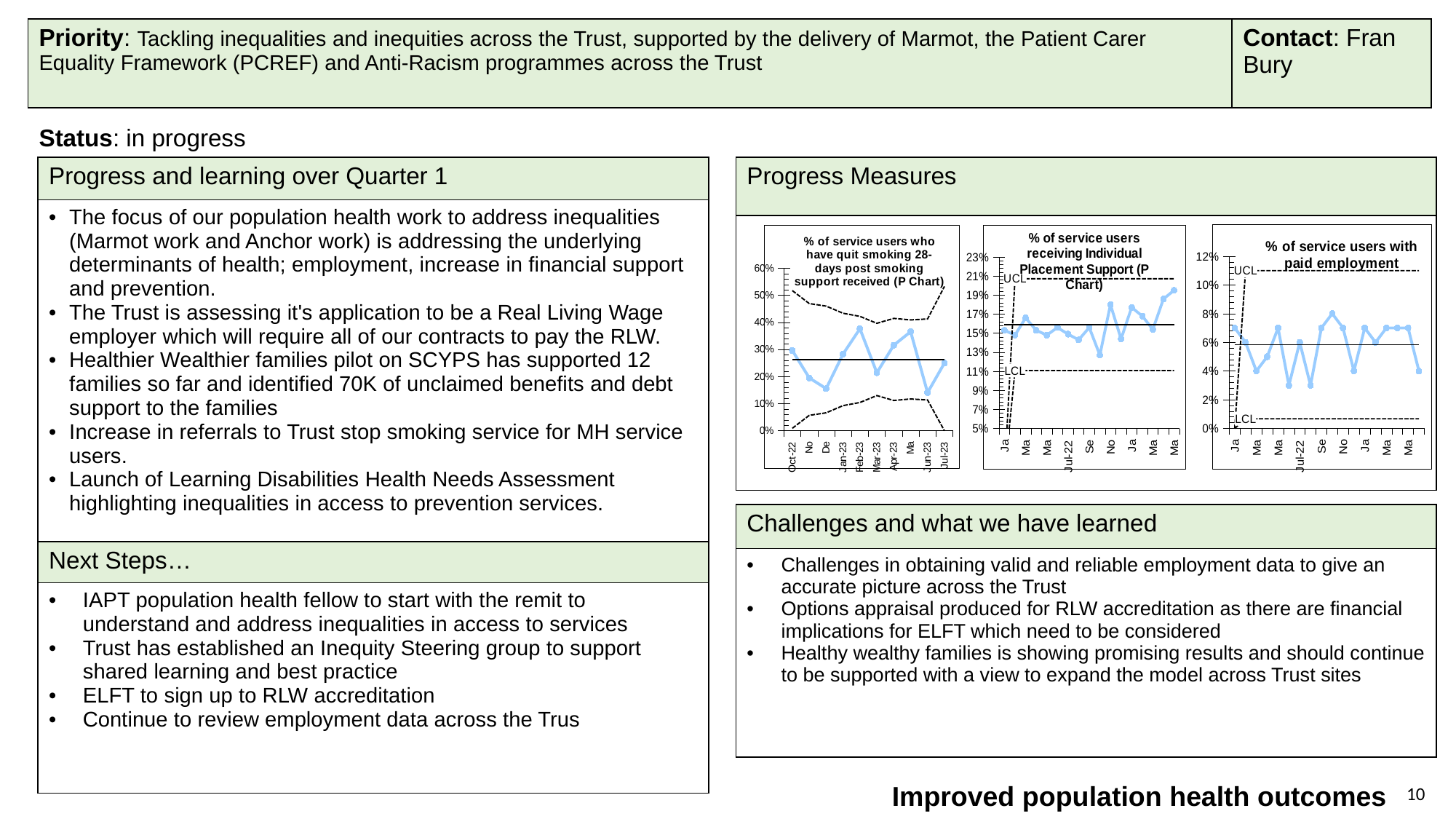
In the '% of service users who have quit smoking' chart, which is larger, the value for Feb-23 or the value for Mar-23? Feb-23 How many charts are shown in the Progress Measures section of the slide? 3 In the '% of service users with paid employment' chart, what is the highest value shown on the vertical axis? 12% What is the title of the rightmost chart on the slide? % of service users with paid employment In the '% of service users who have quit smoking' chart, how many monthly data points are plotted? 10 In the '% of service users who have quit smoking' chart, is the value for Feb-23 greater or less than 30%? greater In the '% of service users receiving Individual Placement Support (P Chart)', does the plotted line end higher or lower than it starts? higher In the '% of service users with paid employment' chart, is the final plotted value greater or less than 6%? less What kind of chart is the '% of service users who have quit smoking 28-days post smoking support received (P Chart)'? line chart In the '% of service users who have quit smoking' chart, is the value for Jun-23 greater or less than 20%? less In the '% of service users who have quit smoking' chart, what is the highest value shown on the vertical axis? 60%